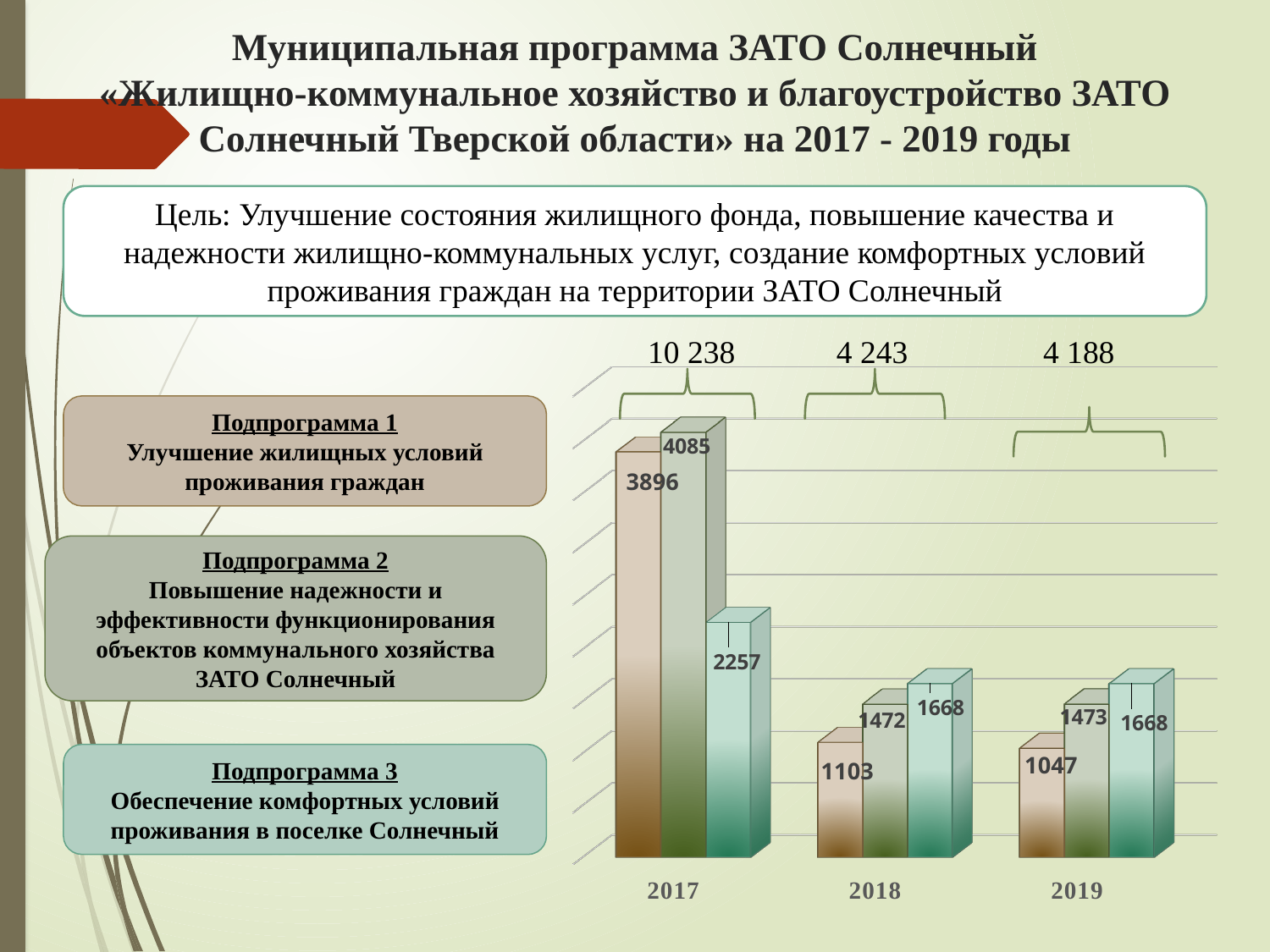
What total is shown above the 2018 group of bars? 4 243 Which year has the highest total shown above its group of bars? 2017 What kind of chart is shown on the slide? bar chart What is the difference between the second bar (4085) and the first bar (3896) in the 2017 group? 189 In the 2018 group, which is larger: the second bar or the third bar? the third bar (1668) What is the value of the third bar in the 2017 group? 2257 What is the value of the first bar in the 2019 group? 1047 Does the value of the first bar in each group rise or fall from 2017 to 2019? fall How many bars are plotted for each year? 3 What is the value of the first (leftmost) bar in the 2017 group? 3896 What is the value of the second bar in the 2017 group? 4085 How many years are shown on the x axis of the chart? 3